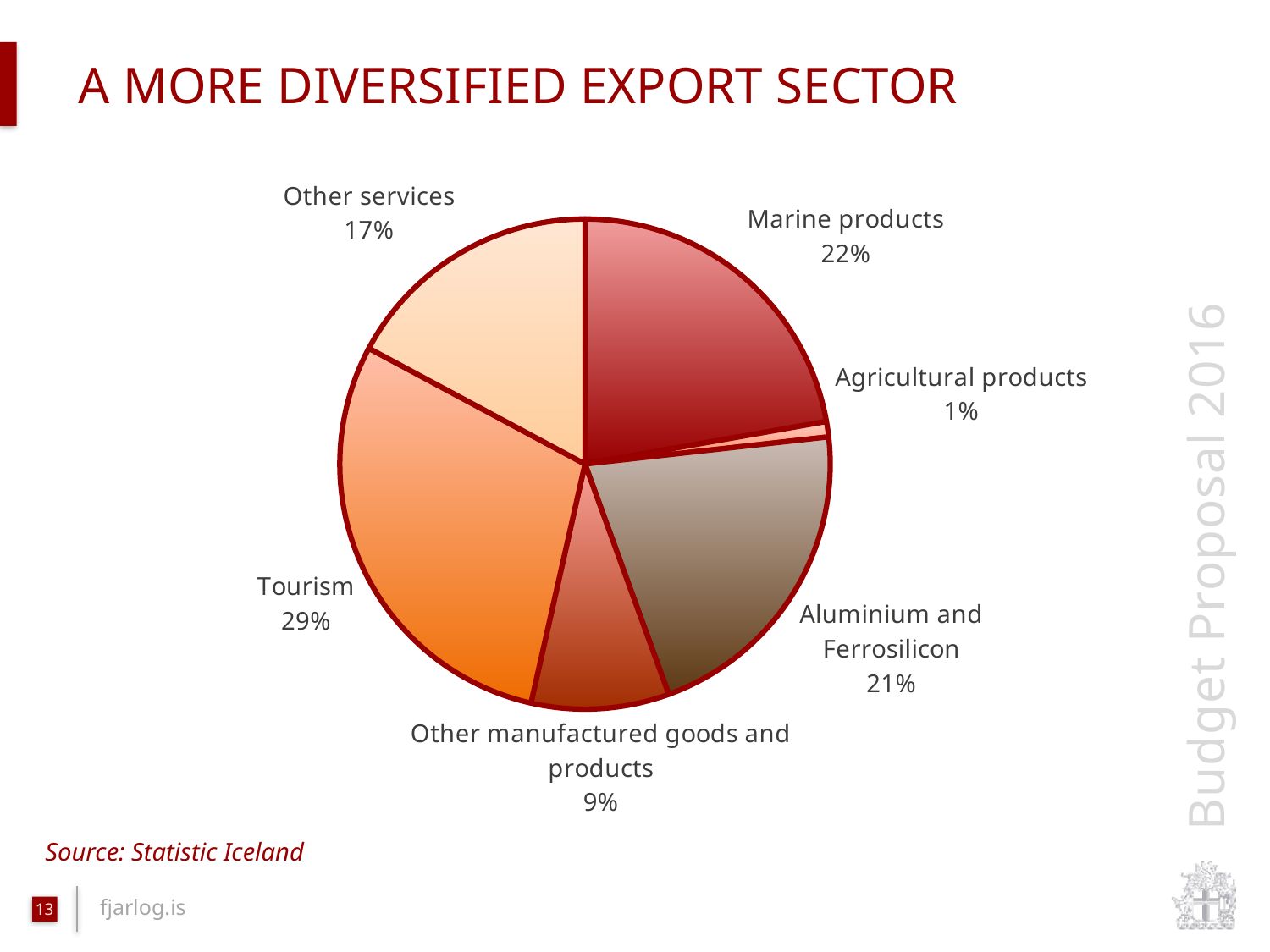
What kind of chart is shown on the slide? Pie chart What is the source cited for the chart data? Statistic Iceland What share of exports does Marine products account for? 22% Which category has the smallest share of the pie? Agricultural products What share of exports does Tourism account for? 29% What share of exports does Other manufactured goods and products account for? 9% Which category has the largest share of the pie? Tourism What is the difference in percentage points between Tourism and Other services? 12 How many categories are shown in the pie chart? 6 Which is larger, the share for Marine products or the share for Other services? Marine products What share of exports does Aluminium and Ferrosilicon account for? 21% What is the title of the slide containing the chart? A MORE DIVERSIFIED EXPORT SECTOR